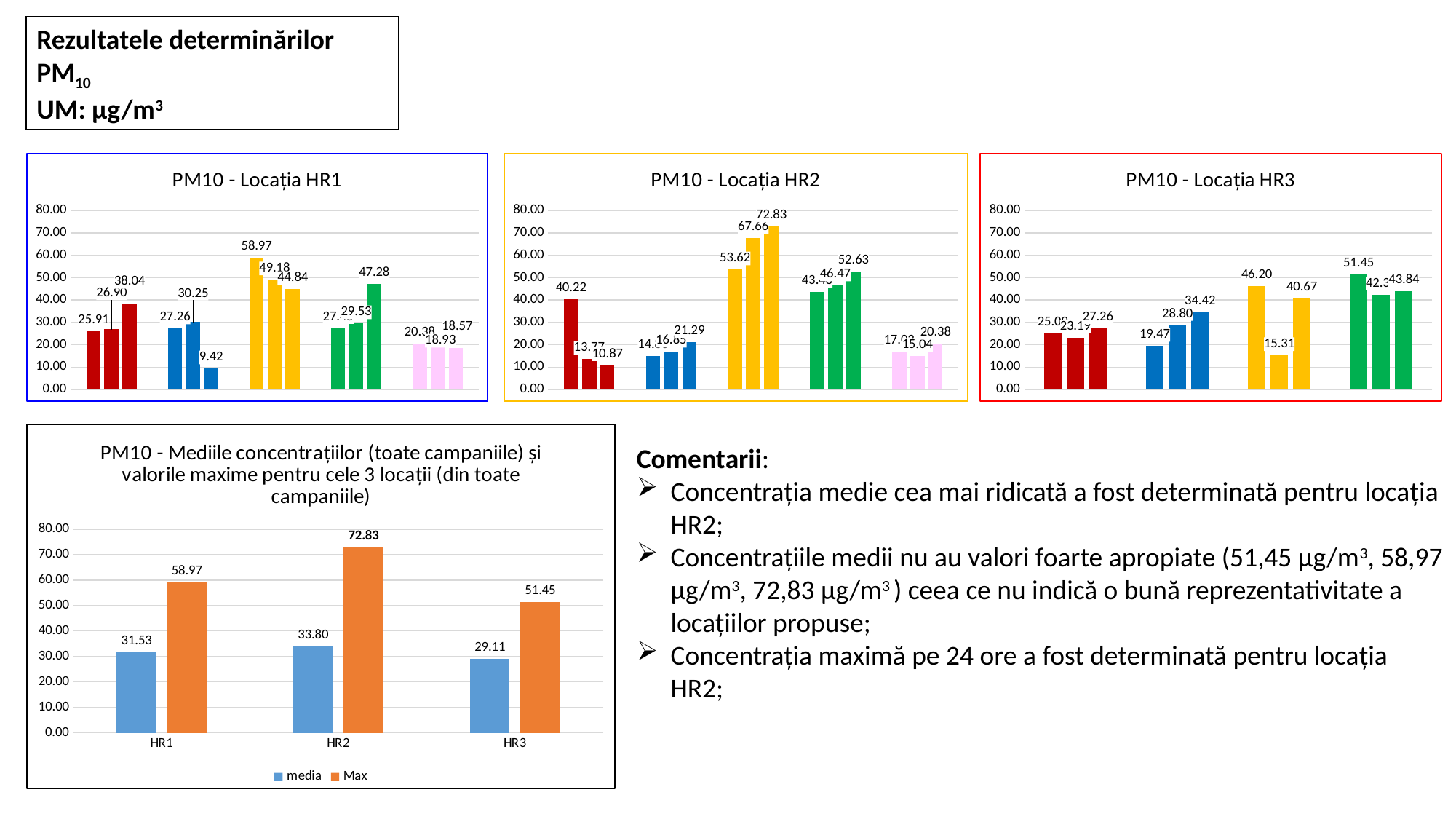
In the bottom-left chart (PM10 - Mediile concentrațiilor), how many series does the legend list? 2 In the 'PM10 - Locația HR2' chart, what is the highest value shown? 72.83 In the bottom-left chart (PM10 - Mediile concentrațiilor), what is the difference between the 'Max' and 'media' values for HR1? 27.44 In the bottom-left chart (PM10 - Mediile concentrațiilor), what is the 'Max' value for HR3? 51.45 In the bottom-left chart (PM10 - Mediile concentrațiilor), which is larger: the 'media' value for HR1 or for HR3? HR1 In the bottom-left chart (PM10 - Mediile concentrațiilor), which location has the highest 'Max' value? HR2 What type of chart is the 'PM10 - Locația HR2' chart? bar chart In the 'PM10 - Locația HR1' chart, what is the lowest value shown? 9.42 In the bottom-left chart (PM10 - Mediile concentrațiilor), how many locations are shown on the x axis? 3 In the bottom-left chart (PM10 - Mediile concentrațiilor), what is the 'media' value for HR2? 33.80 In the bottom-left chart (PM10 - Mediile concentrațiilor), is the 'Max' value for HR2 greater or less than 70.00? greater In the bottom-left chart (PM10 - Mediile concentrațiilor), which location has the lowest 'media' value? HR3